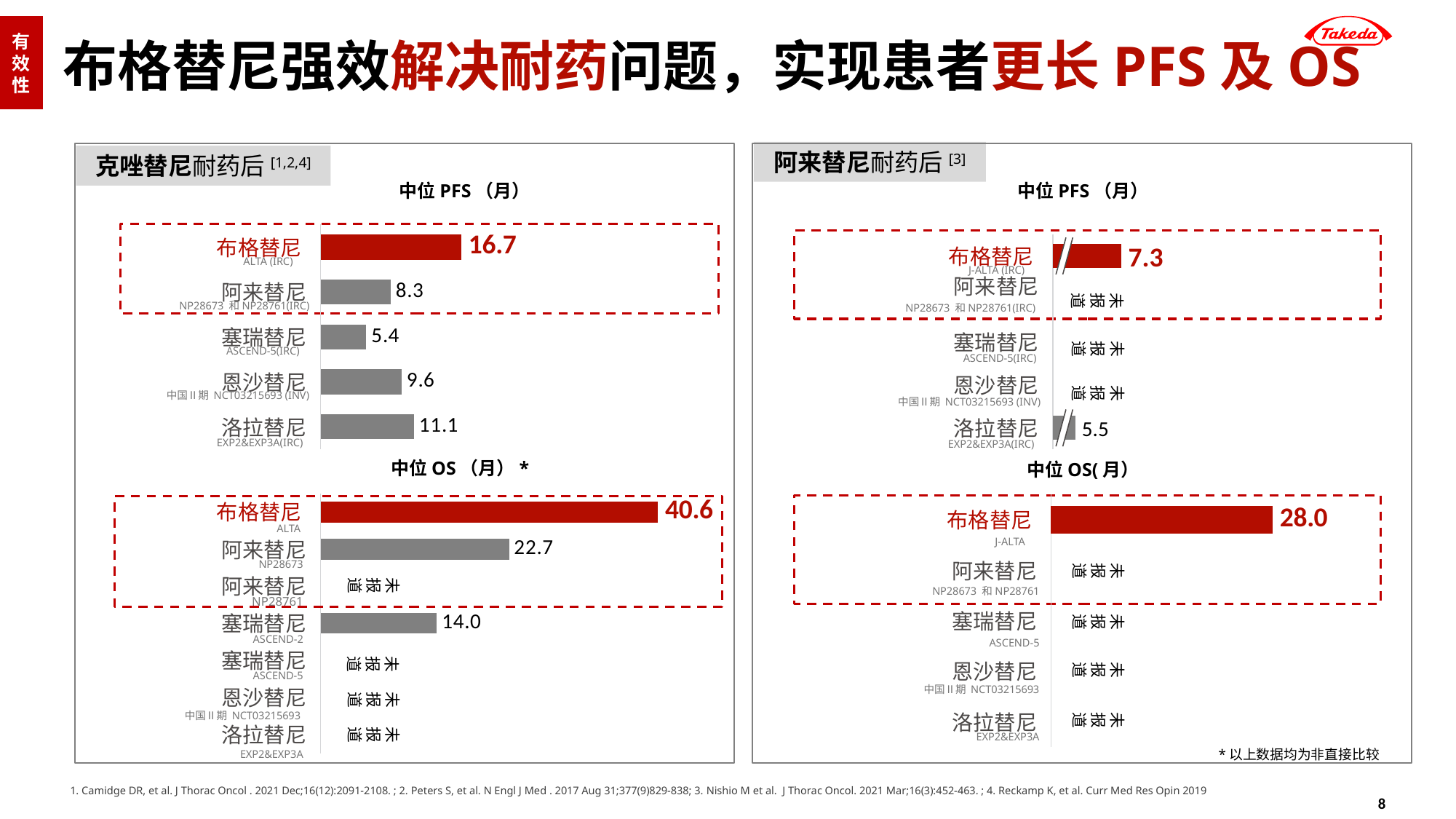
In the 阿来替尼耐药后 panel's 中位 OS chart, what is the value for 布格替尼? 28.0 In the 克唑替尼耐药后 panel's 中位 PFS chart, how many drugs are listed? 5 In the 克唑替尼耐药后 panel's 中位 OS chart, what is the value for 布格替尼? 40.6 In the 阿来替尼耐药后 panel's 中位 PFS chart, what is the value for 布格替尼? 7.3 In the 克唑替尼耐药后 panel's 中位 PFS chart, which drug has the highest median PFS? 布格替尼 In the 克唑替尼耐药后 panel's 中位 PFS chart, what is the difference between 布格替尼 and 阿来替尼? 8.4 In the 阿来替尼耐药后 panel's 中位 PFS chart, what is the value for 洛拉替尼? 5.5 In the 克唑替尼耐药后 panel's 中位 PFS chart, what is the value for 布格替尼? 16.7 In the 克唑替尼耐药后 panel's 中位 PFS chart, which drug has the lowest median PFS? 塞瑞替尼 In the 克唑替尼耐药后 panel's 中位 OS chart, which is larger, 布格替尼 or 阿来替尼 (NP28673)? 布格替尼 In the 克唑替尼耐药后 panel's 中位 OS chart, what is the value for 塞瑞替尼 (ASCEND-2)? 14.0 In the 克唑替尼耐药后 panel's 中位 PFS chart, what is the value for 洛拉替尼? 11.1